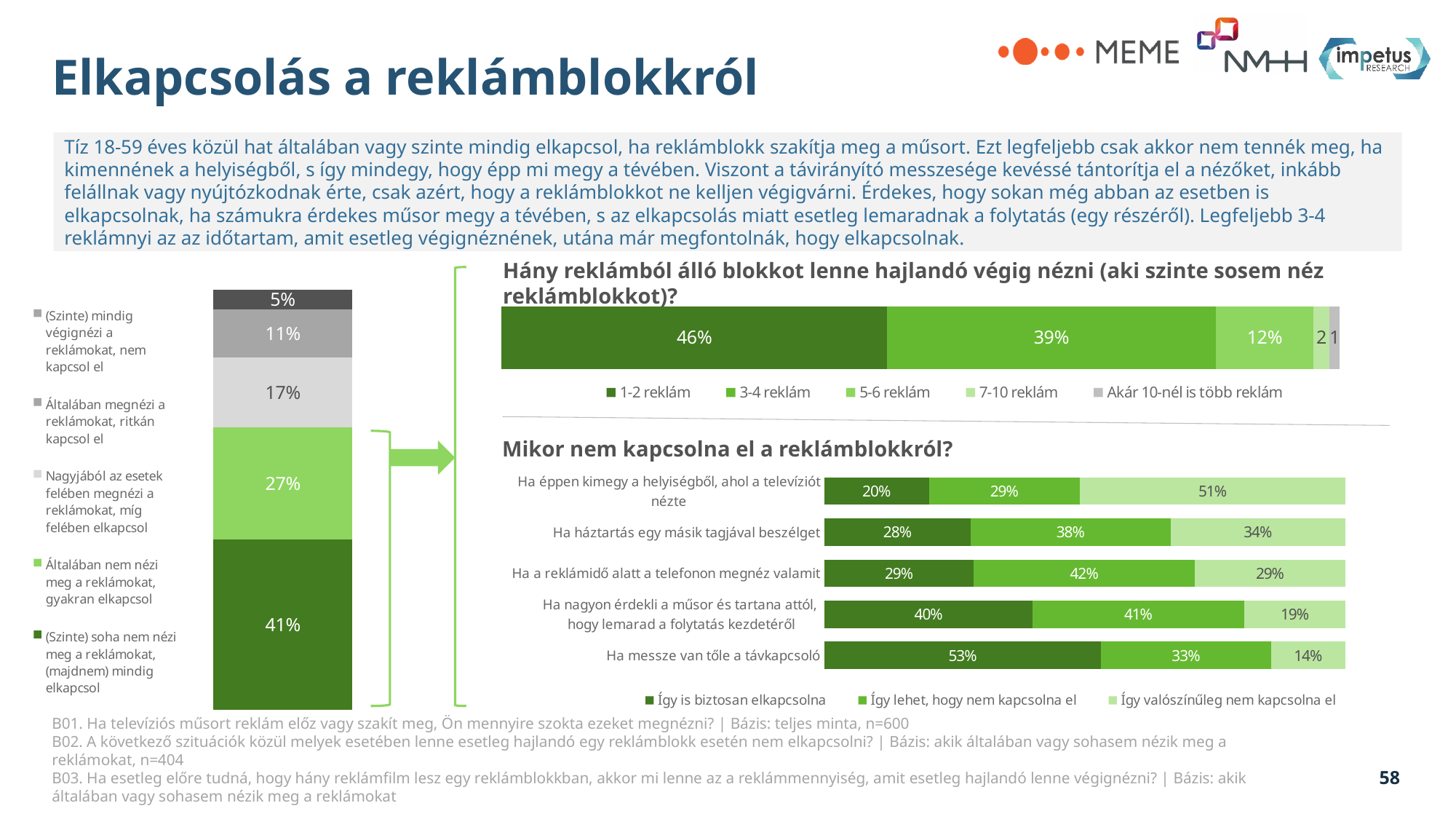
In the chart titled 'Hány reklámból álló blokkot lenne hajlandó végig nézni', what percentage is shown for '3-4 reklám'? 39% How many situations (categories) are shown in the chart titled 'Mikor nem kapcsolna el a reklámblokkról?'? 5 In the chart on the left of the slide, which segment has the smallest value? (Szinte) mindig végignézi a reklámokat, nem kapcsol el What type of chart is the chart titled 'Mikor nem kapcsolna el a reklámblokkról?'? Stacked bar chart In the chart on the left of the slide, what is the difference between the 'Általában nem nézi meg a reklámokat, gyakran elkapcsol' segment and the 'Nagyjából az esetek felében megnézi a reklámokat' segment? 10% In the chart titled 'Mikor nem kapcsolna el a reklámblokkról?', which situation has the highest 'Így is biztosan elkapcsolna' value? Ha messze van tőle a távkapcsoló How many categories does the legend list in the chart titled 'Hány reklámból álló blokkot lenne hajlandó végig nézni'? 5 In the chart on the left of the slide, what percentage is shown for the segment '(Szinte) soha nem nézi meg a reklámokat, (majdnem) mindig elkapcsol'? 41% In the chart titled 'Mikor nem kapcsolna el a reklámblokkról?', what is the value of 'Így valószínűleg nem kapcsolna el' for 'Ha éppen kimegy a helyiségből, ahol a televíziót nézte'? 51% In the chart titled 'Hány reklámból álló blokkot lenne hajlandó végig nézni', which category has the highest value? 1-2 reklám In the chart titled 'Mikor nem kapcsolna el a reklámblokkról?', which is larger for 'Ha háztartás egy másik tagjával beszélget': 'Így lehet, hogy nem kapcsolna el' or 'Így valószínűleg nem kapcsolna el'? Így lehet, hogy nem kapcsolna el In the chart titled 'Mikor nem kapcsolna el a reklámblokkról?', what is the value of 'Így is biztosan elkapcsolna' for 'Ha messze van tőle a távkapcsoló'? 53%